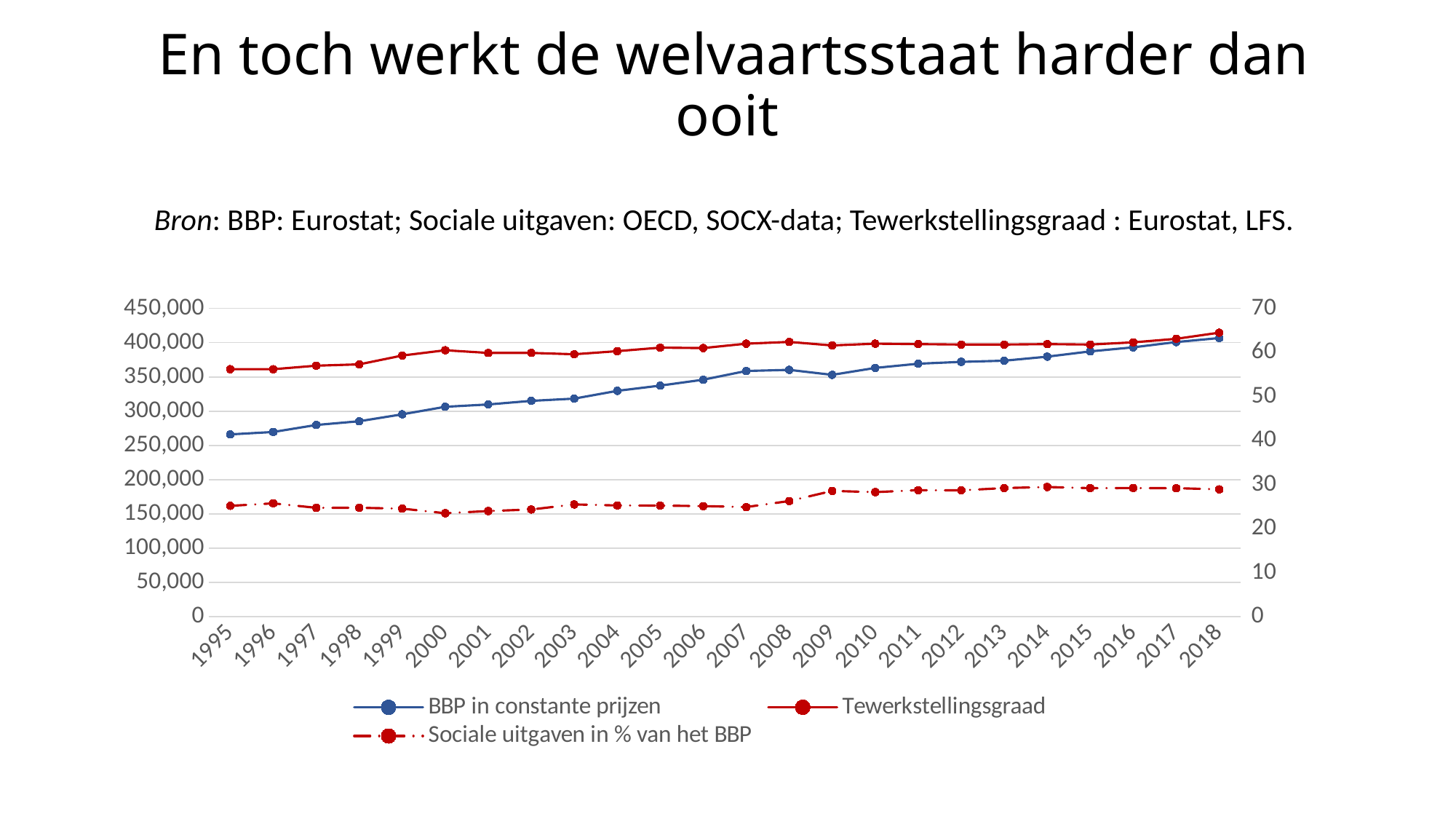
In which year is 'BBP in constante prijzen' at its lowest? 1995 What kind of chart is shown on the slide? line chart How many series does the legend list? 3 Which series is drawn with a dashed line? Sociale uitgaven in % van het BBP How many years are plotted along the x axis? 24 Which is larger for 'BBP in constante prijzen': the value in 2008 or the value in 2009? 2008 In which year is 'BBP in constante prijzen' at its highest? 2018 Does the series 'BBP in constante prijzen' generally rise or fall from 1995 to 2018? rise Is the value for 'Tewerkstellingsgraad' in 1995 greater or less than 50 on the right-hand axis? greater In which year is 'Sociale uitgaven in % van het BBP' at its lowest? 2000 What is the highest value shown on the right-hand y axis? 70 Is the value for 'BBP in constante prijzen' in 1995 greater or less than 300,000? less